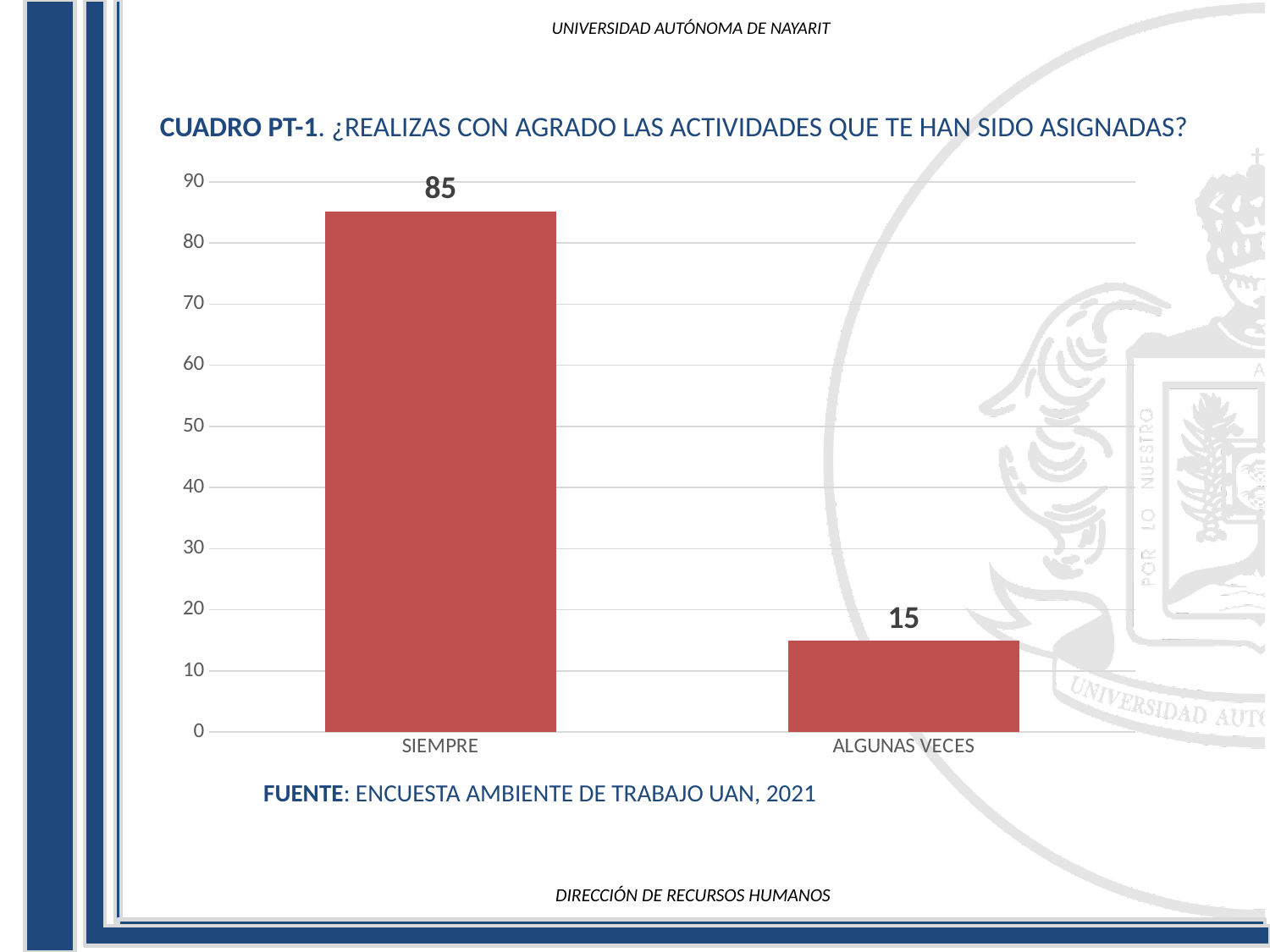
What is the value for SIEMPRE? 85 What is the value for ALGUNAS VECES? 15 Which is larger, the value for SIEMPRE or the value for ALGUNAS VECES? SIEMPRE Which category has the highest value? SIEMPRE What kind of chart is shown on the slide? bar chart What is the total of the two values shown in the chart? 100 Is the value for SIEMPRE greater or less than 80? greater What source is cited below the chart? ENCUESTA AMBIENTE DE TRABAJO UAN, 2021 Is the value for ALGUNAS VECES greater or less than 20? less What is the difference between the values for SIEMPRE and ALGUNAS VECES? 70 How many categories are shown on the x axis? 2 Which category has the lowest value? ALGUNAS VECES